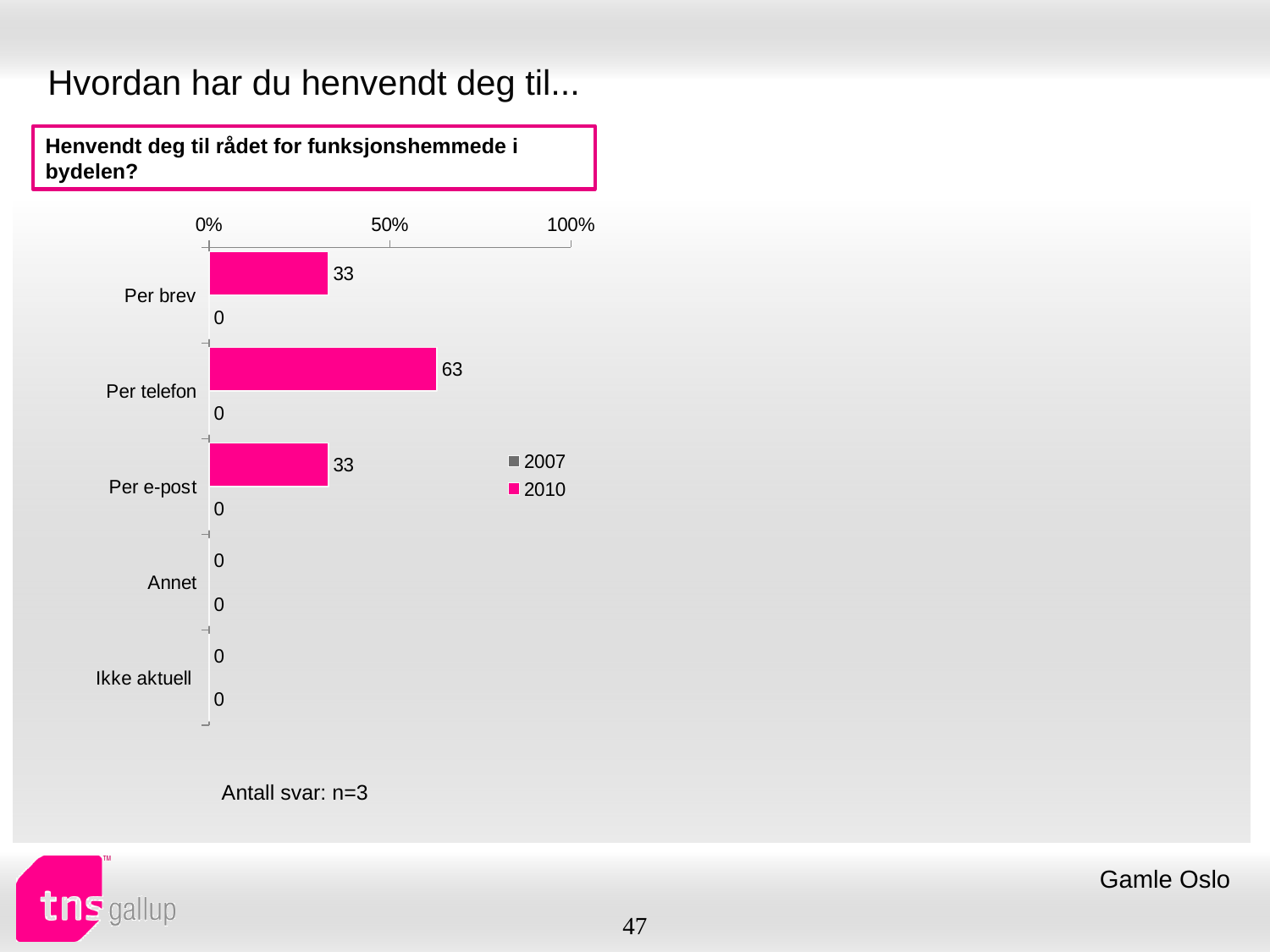
What is the 2010 value for Per brev? 33 What is the 2010 value for Per e-post? 33 Is the 2010 value for Per telefon greater or less than 50%? greater What is the 2010 value for Per telefon? 63 Which category has the highest 2010 value? Per telefon What is the 2007 value for Per telefon? 0 What is the difference between the 2010 values for Per telefon and Per brev? 30 Which colour represents the 2010 series in the legend? pink How many series does the legend list? 2 What type of chart is shown on the slide? bar chart How many categories are shown on the chart? 5 Which is larger, the 2010 value for Per telefon or the 2010 value for Per e-post? Per telefon